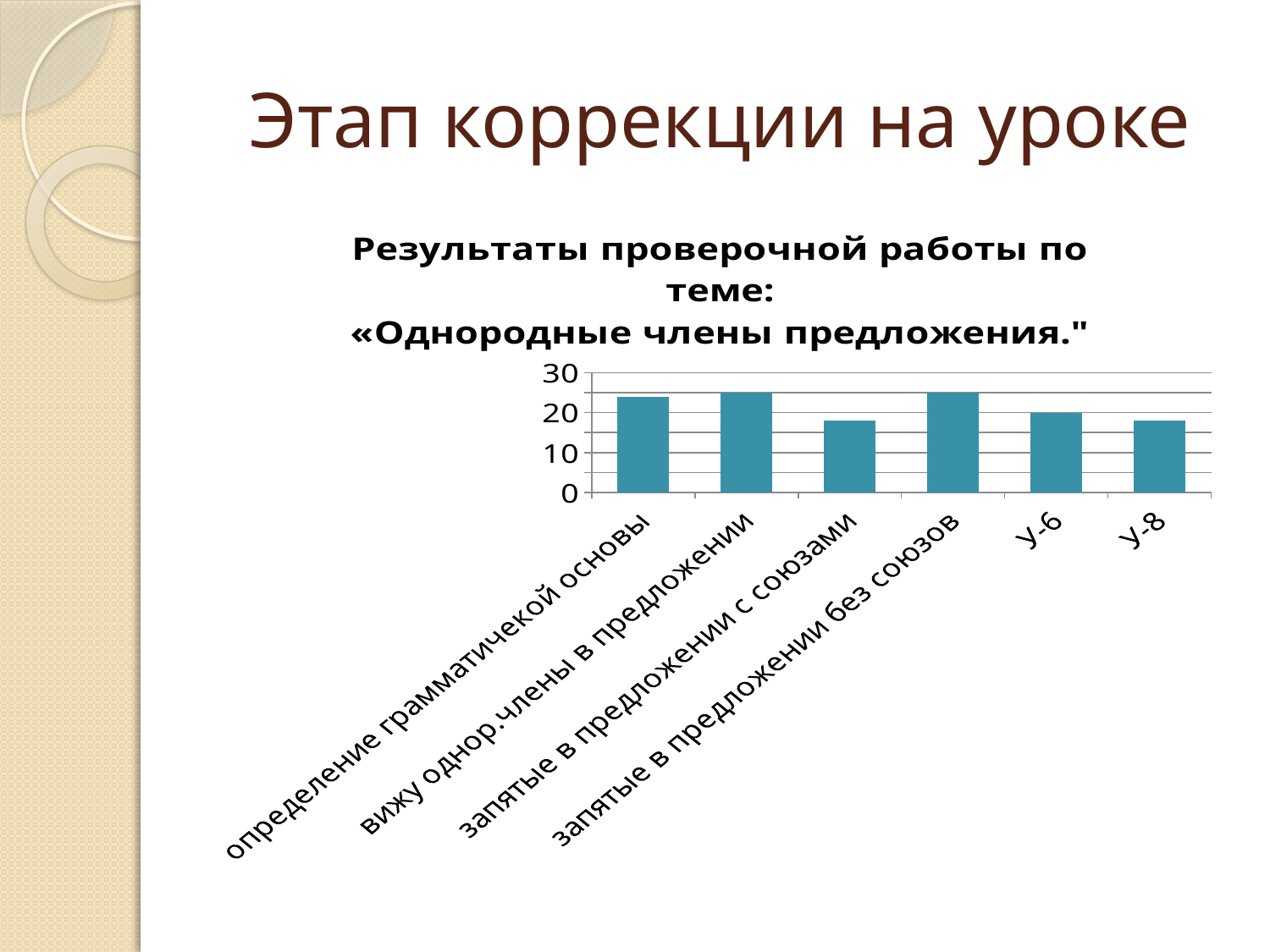
Is the value for "определение грамматической основы" greater or less than 20? greater Is the value for "запятые в предложении с союзами" greater or less than 20? less Which is larger: the value for "определение грамматической основы" or the value for "запятые в предложении с союзами"? определение грамматической основы What is the highest value shown on the vertical axis of the chart? 30 What is the label of the last category on the x axis of the chart? У-8 Which is larger: the value for "вижу однор.члены в предложении" or the value for "У-8"? вижу однор.члены в предложении Is the value for "вижу однор.члены в предложении" greater or less than 30? less How many categories are plotted on the chart? 6 Which is larger: the value for "запятые в предложении без союзов" or the value for "У-6"? запятые в предложении без союзов What kind of chart is shown on the slide? bar chart